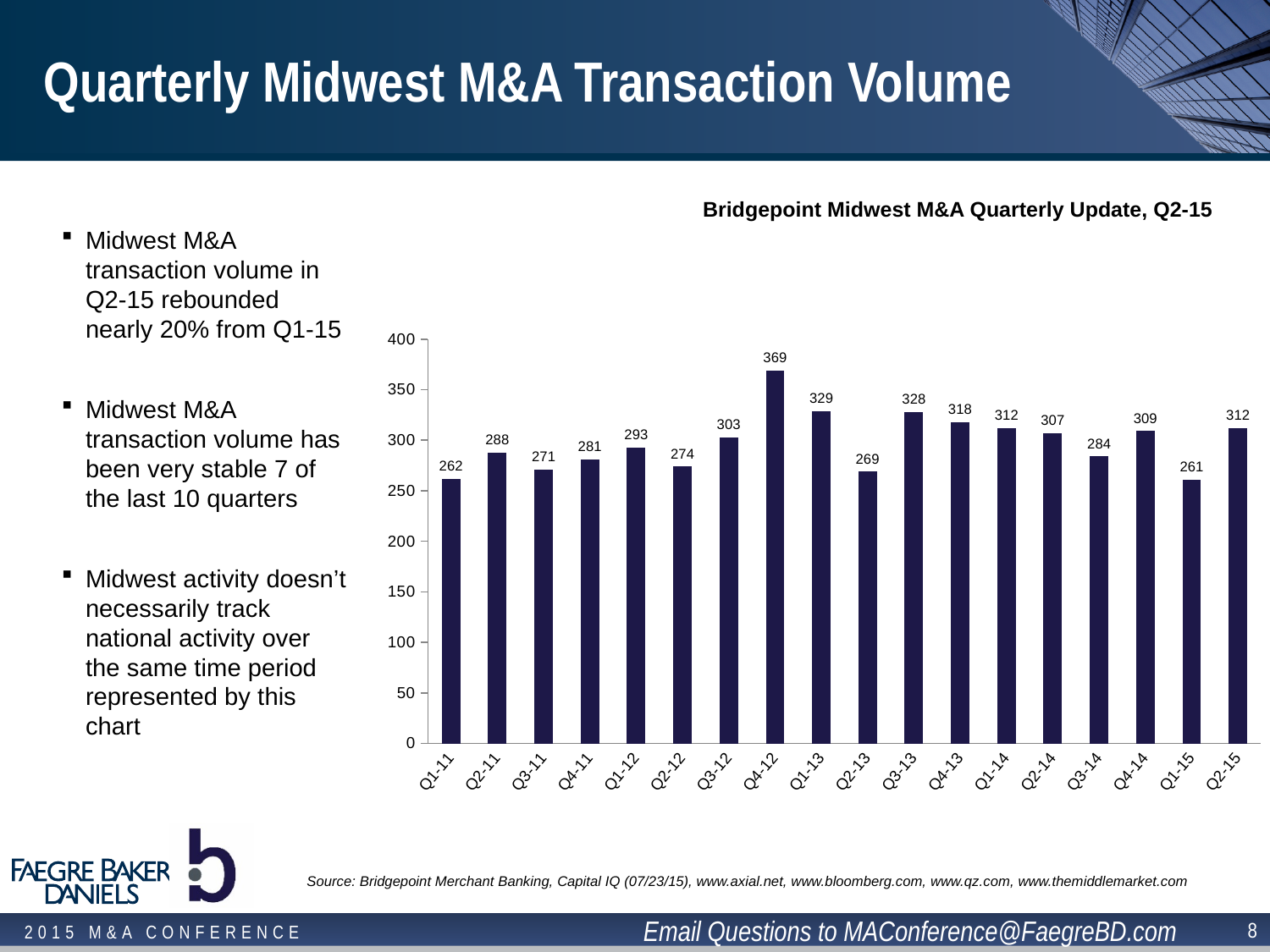
What is the value for Q2-15? 312 Is the value for Q4-12 greater or less than 350? greater Which is larger, the value for Q1-13 or the value for Q2-13? Q1-13 What is the difference between the values for Q2-15 and Q1-15? 51 What kind of chart is shown on the slide? bar chart What is the value for Q1-15? 261 Which quarter has the highest value? Q4-12 What is the value for Q4-12? 369 Is the value for Q1-15 greater or less than 300? less How many quarters are shown on the x axis? 18 What is the difference between the values for Q4-12 and Q1-12? 76 What is the title of the chart? Bridgepoint Midwest M&A Quarterly Update, Q2-15